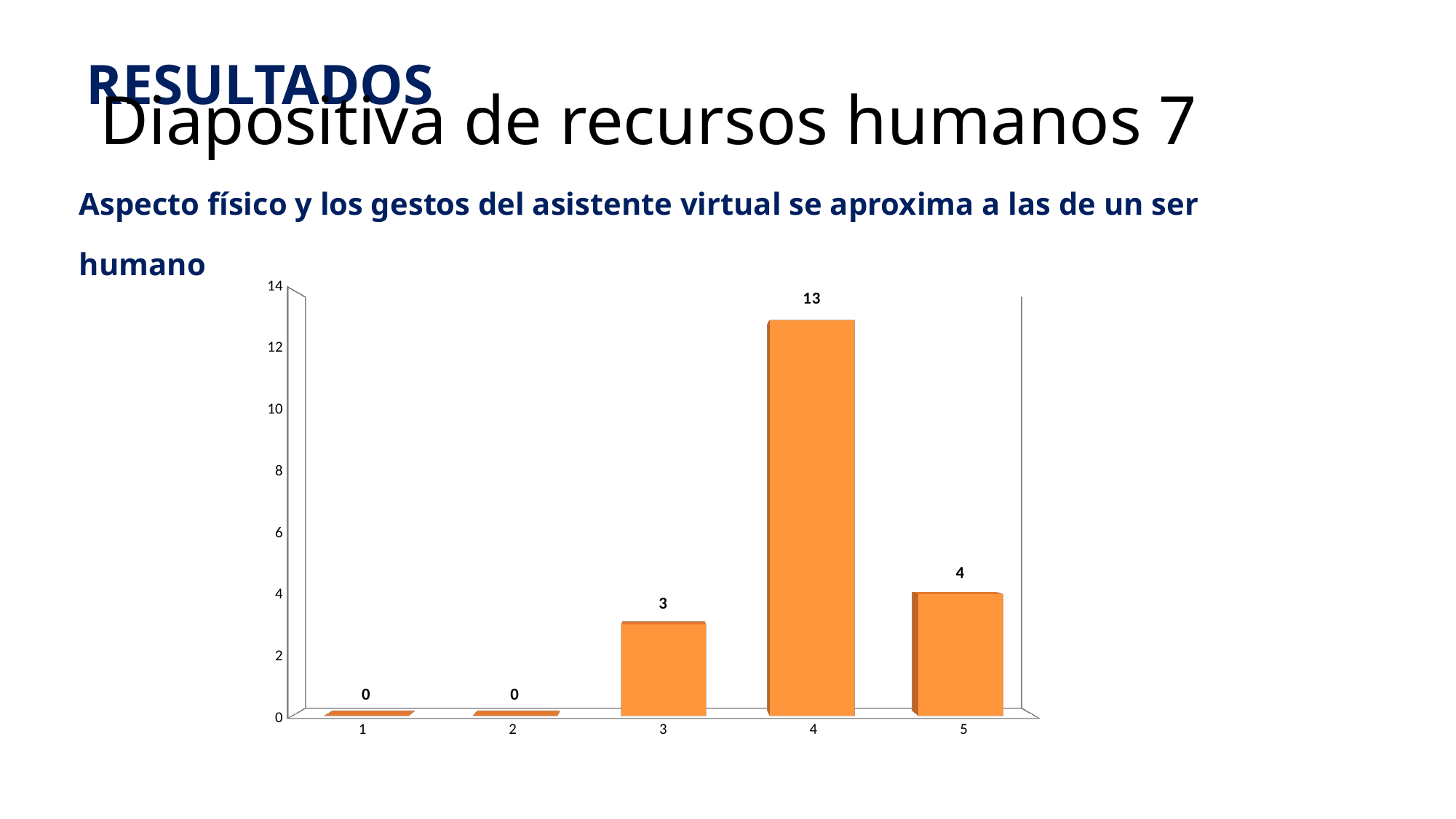
Which category has the highest value? 4 Is the value for category 4 greater or less than 12? greater What is the value for category 5? 4 Which is larger, the value for category 3 or the value for category 5? 5 How many categories have a value of 0? 2 What is the difference between the values for category 5 and category 3? 1 How many categories are shown on the x axis? 5 What is the value for category 4? 13 What is the value for category 1? 0 What is the value for category 3? 3 What is the difference between the values for category 4 and category 5? 9 What kind of chart is shown on the slide? bar chart